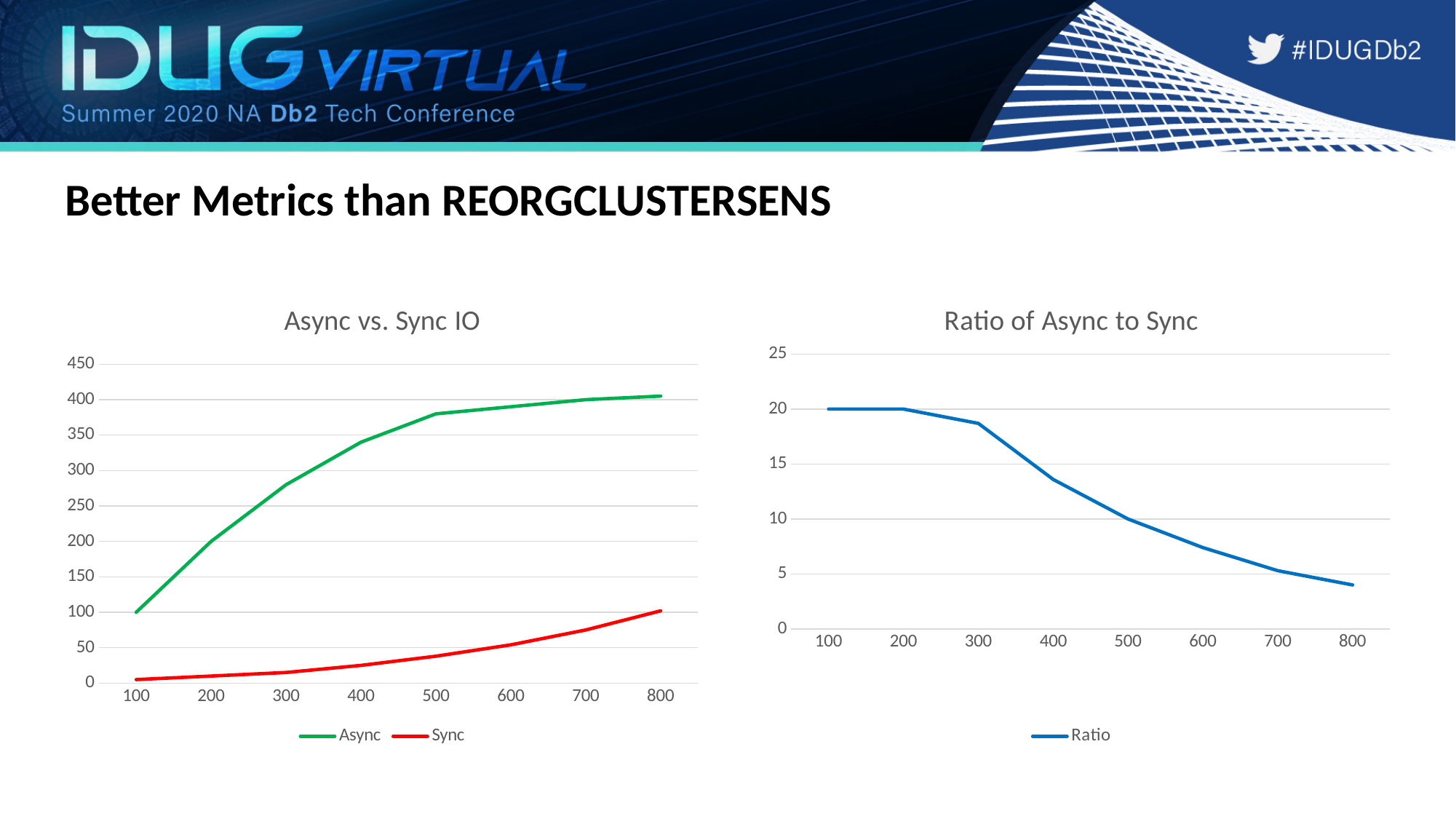
What colour is the Sync line in the 'Async vs. Sync IO' chart? red In the 'Ratio of Async to Sync' chart, is the Ratio at 400 greater or less than 10? greater In the 'Ratio of Async to Sync' chart, at which x-axis value is the Ratio lowest? 800 In the 'Async vs. Sync IO' chart, is the Sync value at 500 greater or less than 50? less How many series does the legend of the 'Async vs. Sync IO' chart list? 2 In the 'Ratio of Async to Sync' chart, does the Ratio rise or fall as the x-axis value increases? fall In the 'Async vs. Sync IO' chart, does the Async series rise or fall along the x axis? rise In the 'Async vs. Sync IO' chart, which series has the larger value at 400, Async or Sync? Async In the 'Ratio of Async to Sync' chart, is the Ratio at 800 greater or less than 5? less How many x-axis points are plotted in the 'Ratio of Async to Sync' chart? 8 What kind of chart is the 'Async vs. Sync IO' chart? line chart